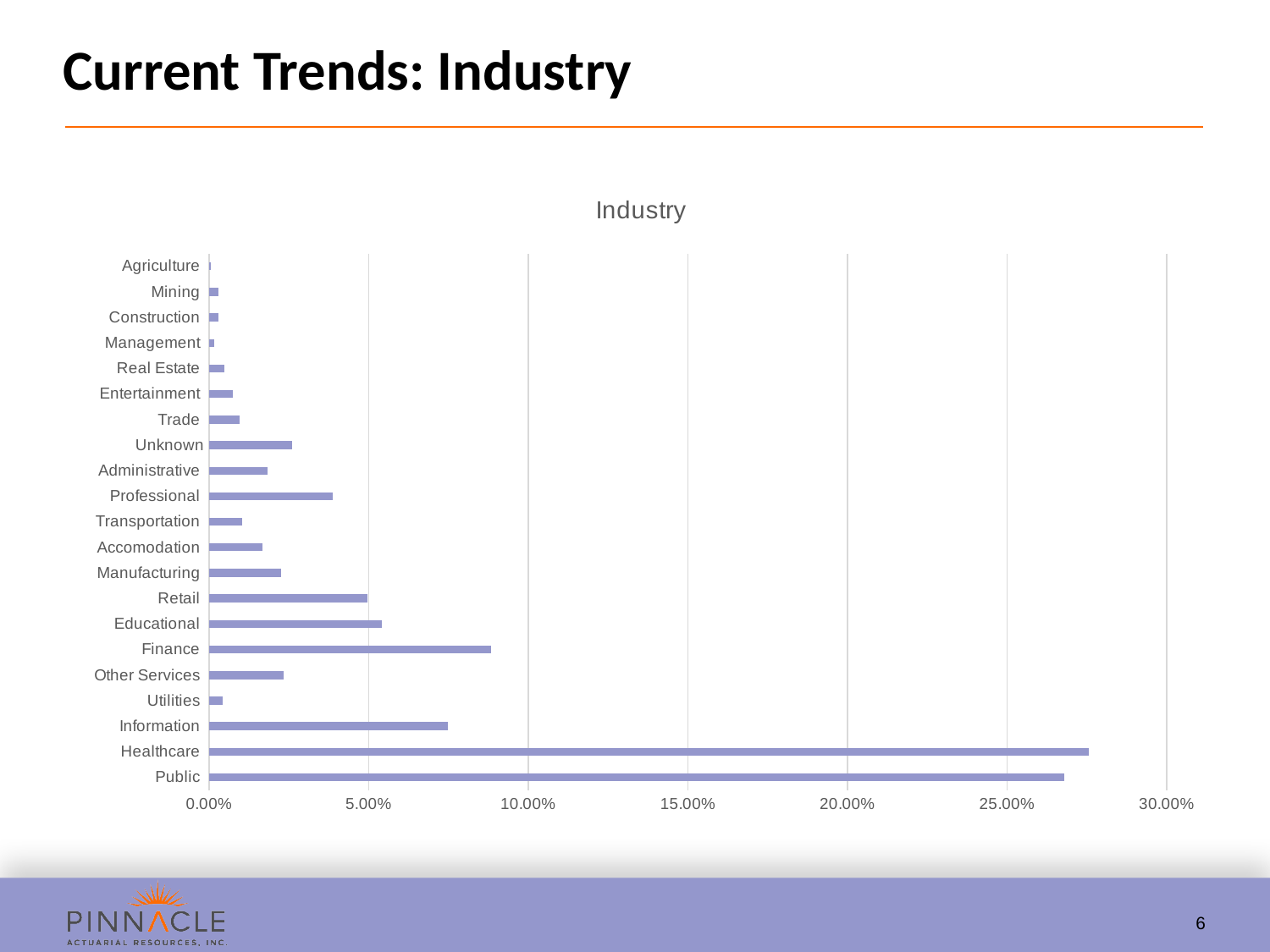
Which industry has the highest value in the chart? Healthcare Is the value for Information greater or less than 5.00%? greater What kind of chart is shown on the slide? bar chart What is the title of the chart? Industry Is the value for Finance greater or less than 10.00%? less Is the value for Professional greater or less than 5.00%? less What is the maximum value shown on the horizontal axis? 30.00% Which has the larger value, Unknown or Administrative? Unknown Which has the larger value, Finance or Information? Finance How many industry categories are plotted in the chart? 21